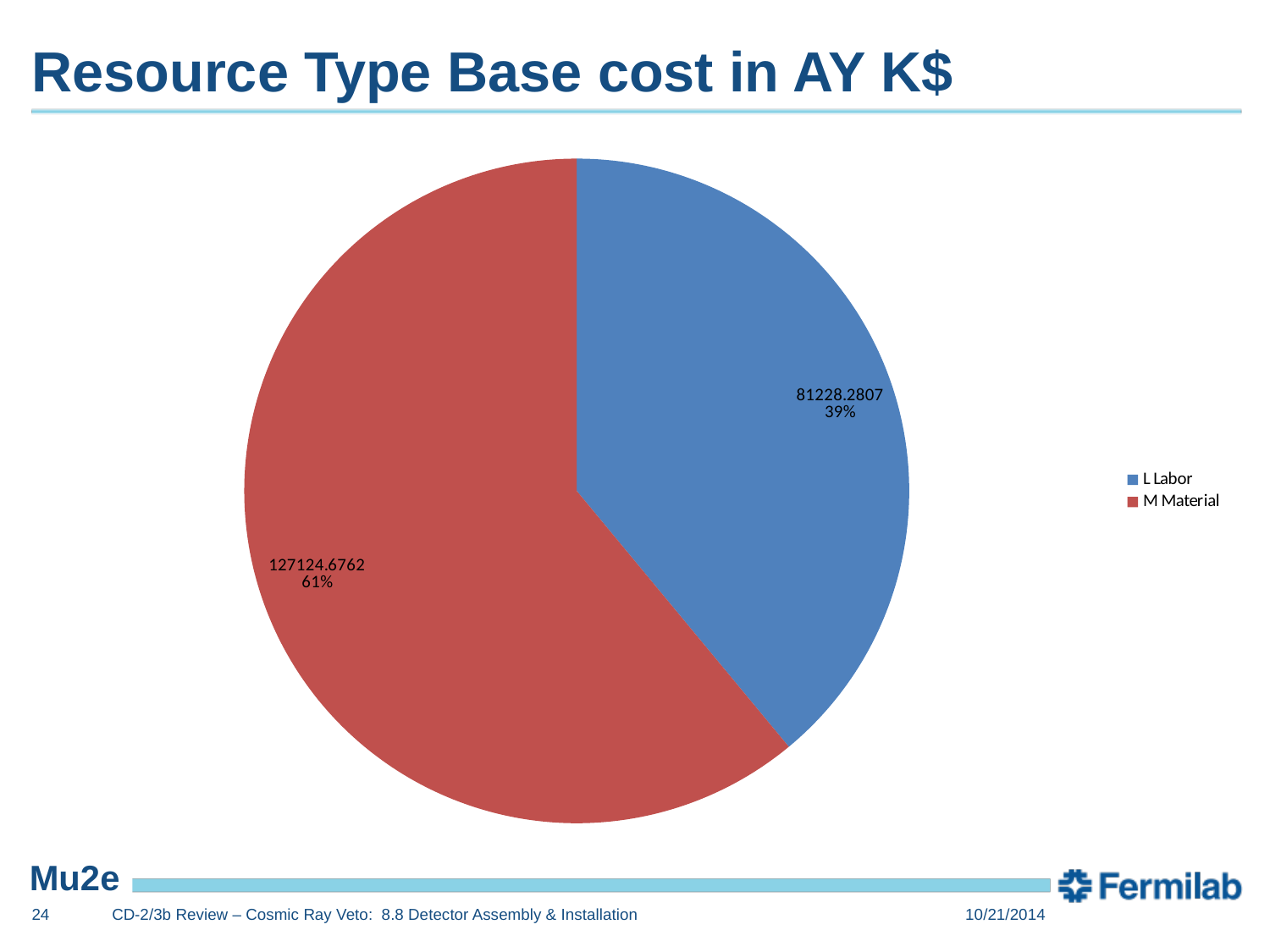
What is the value shown for M Material? 127124.6762 What is the title of the chart on the slide? Resource Type Base cost in AY K$ Which is larger, the value for L Labor or the value for M Material? M Material Which resource type has the largest slice of the pie? M Material What share of the pie does M Material represent? 61% What kind of chart is shown on the slide? Pie chart What is the difference between the M Material value and the L Labor value? 45896.3955 What is the value shown for L Labor? 81228.2807 Which resource type has the smallest slice of the pie? L Labor What share of the pie does L Labor represent? 39% How many slices does the pie chart have? 2 What is the total of the two slices in the pie? 208352.9569